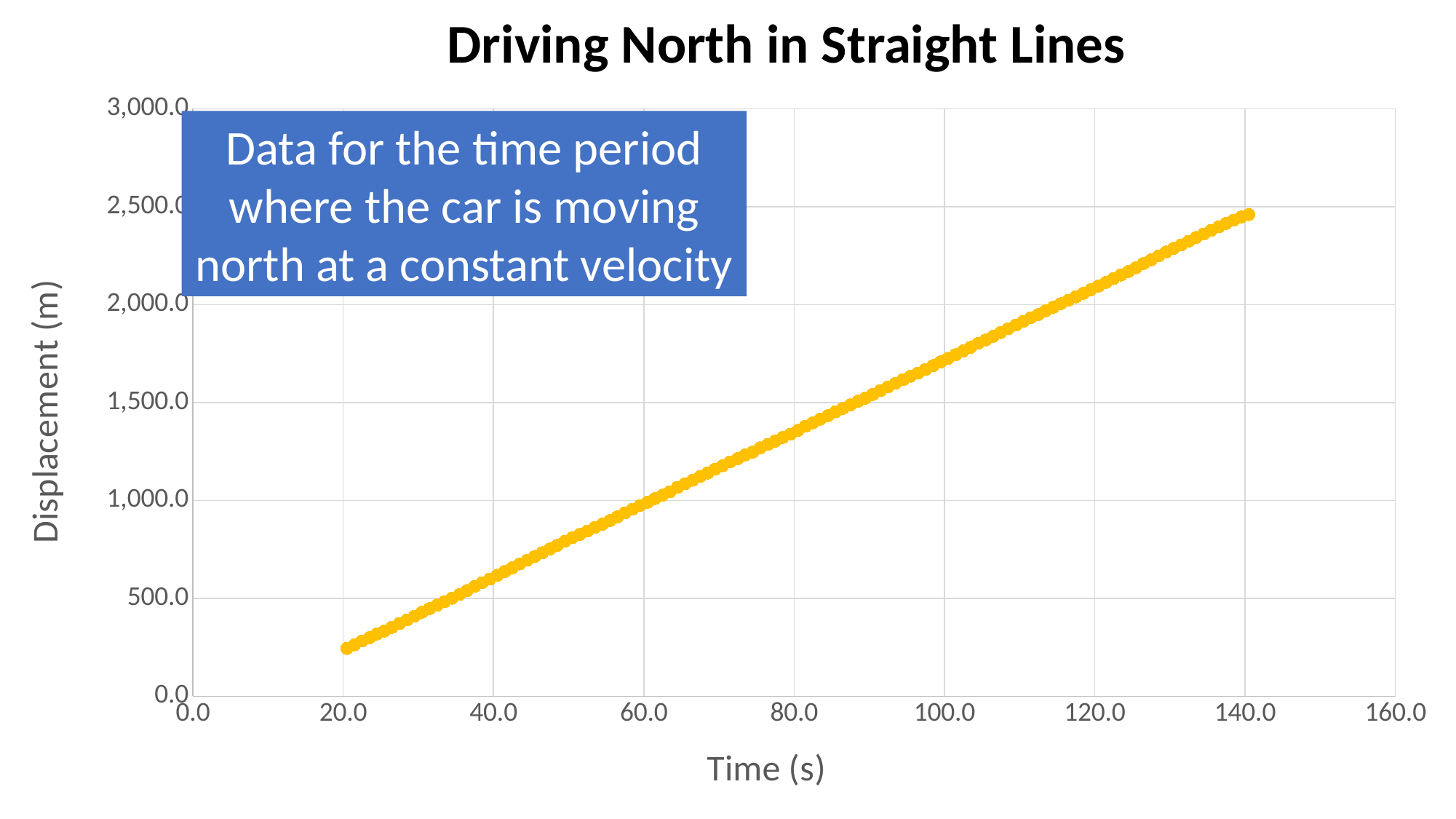
Is the highest displacement plotted greater or less than 2,500.0 m? less Is the displacement at a time of 40.0 s greater or less than 500.0 m? greater What is the label of the vertical axis? Displacement (m) Do the displacement values rise or fall as time increases along the x axis? rise What is the title of the chart? Driving North in Straight Lines Is the displacement at a time of 100.0 s greater or less than 2,000.0 m? less What kind of chart is shown on the slide? scatter chart